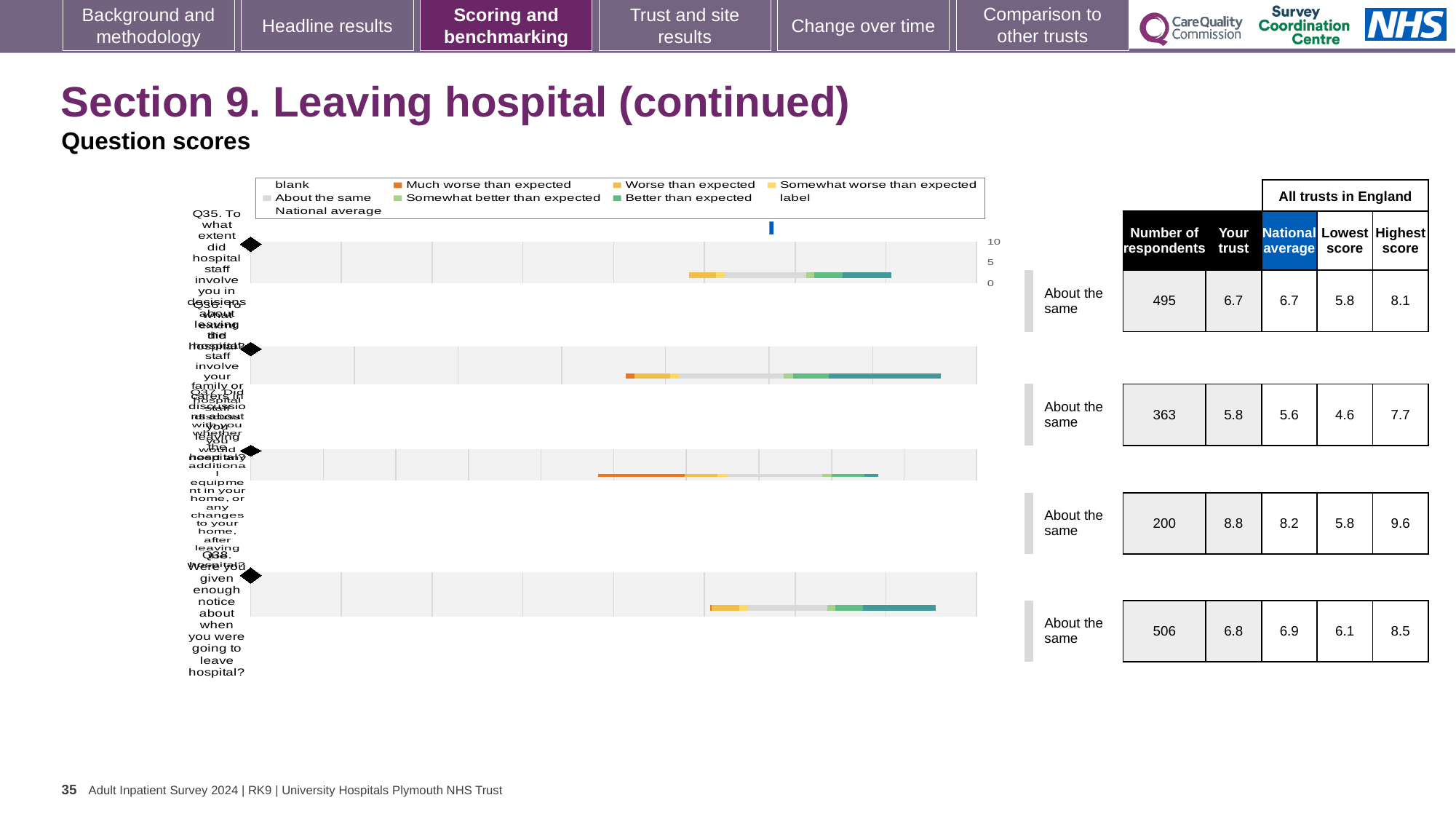
In the table beside the chart, which row has the lowest number of respondents? Q37 (third row), 200 How many question bars are plotted in the chart? 4 In the table beside the chart, how many respondents are listed for Q38 (the last row)? 506 In the table beside the chart, is the 'Your trust' score for the second row (Q36) larger or smaller than its national average? larger How many entries does the chart legend list? 9 In the table beside the chart, what is the national average for the third row (Q37)? 8.2 In the table beside the chart, what is the difference between the highest score and lowest score for Q38 (the last row)? 2.4 What is the highest tick value shown on the chart's axis? 10 What benchmark category is shown next to each of the four question bars? About the same In the table beside the chart, which row has the highest 'Your trust' score? Q37 (third row), 8.8 In the table beside the chart, what is the 'Your trust' score for Q35 (the first row)? 6.7 What kind of chart is shown on the slide? bar chart